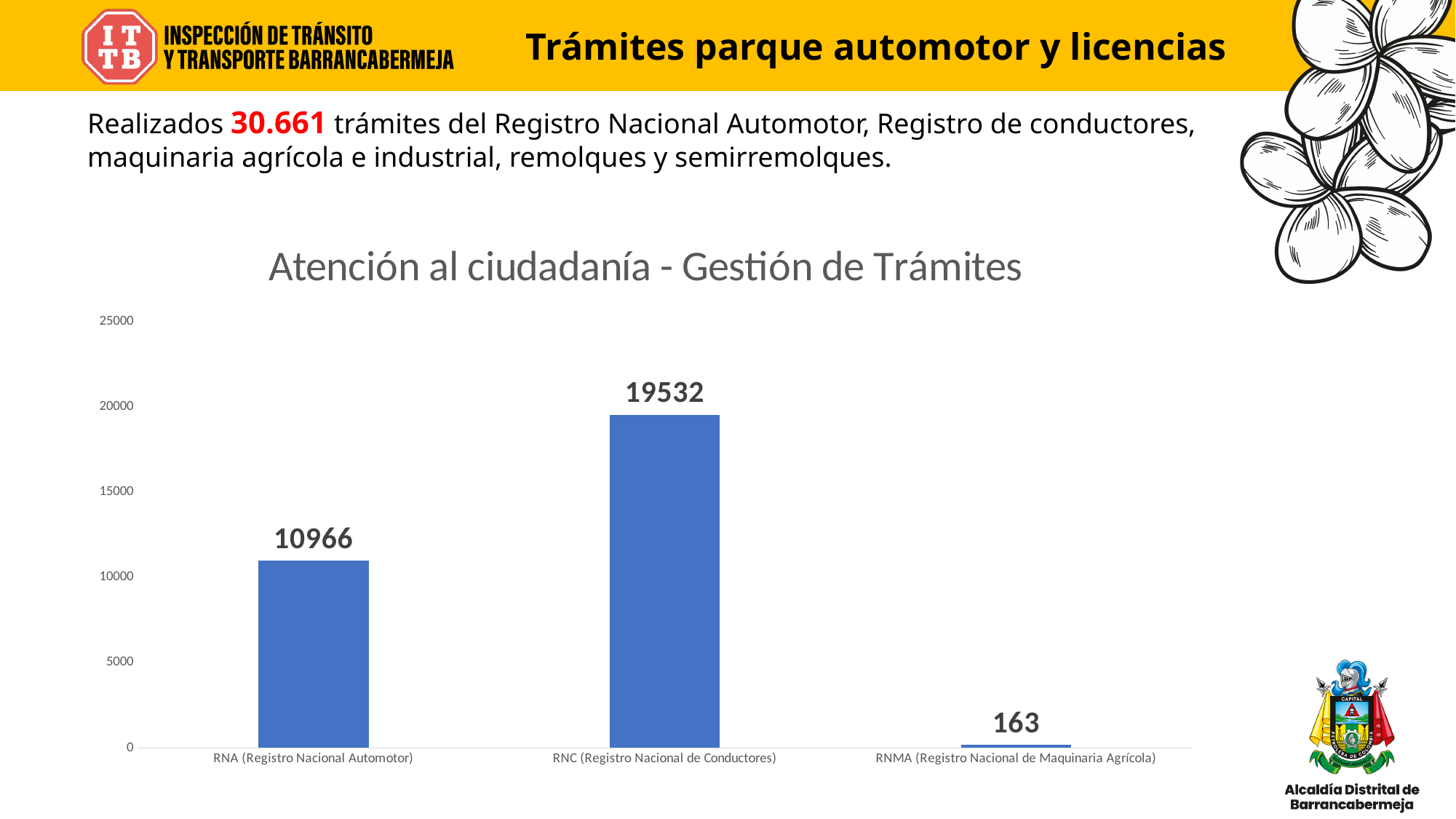
Which category has the lowest value? RNMA (Registro Nacional de Maquinaria Agrícola) What kind of chart is shown on the slide? bar chart How many categories are shown in the chart? 3 Which is larger, the value for RNA or the value for RNC? RNC What is the title of the chart? Atención al ciudadanía - Gestión de Trámites What is the difference between the values for RNA and RNMA? 10803 Is the value for RNA (Registro Nacional Automotor) greater or less than 10000? greater Which category has the highest value? RNC (Registro Nacional de Conductores) What is the value for RNC (Registro Nacional de Conductores)? 19532 What is the value for RNA (Registro Nacional Automotor)? 10966 What is the value for RNMA (Registro Nacional de Maquinaria Agrícola)? 163 What is the difference between the values for RNC and RNA? 8566